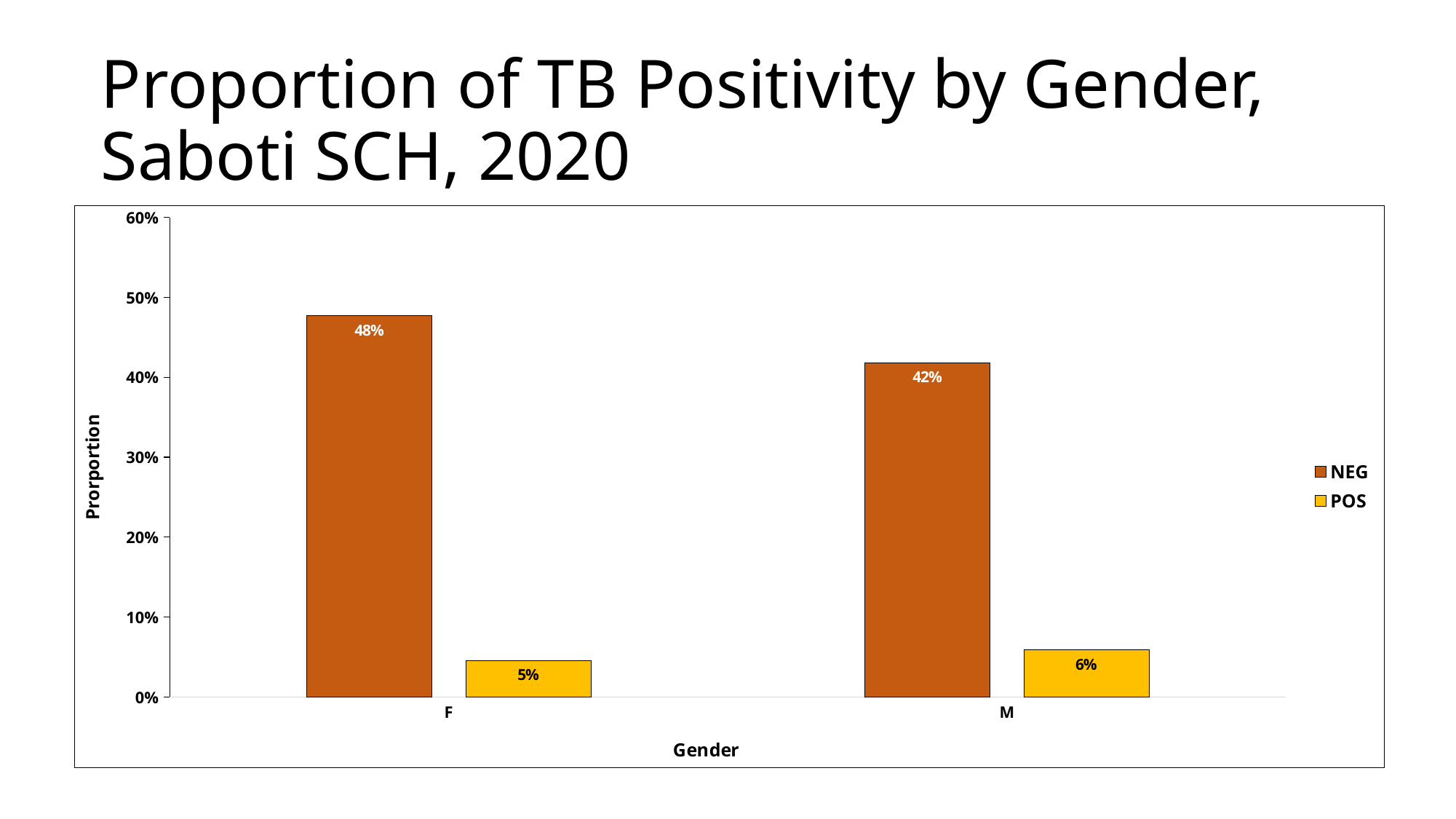
How many series does the legend list? 2 What is the difference between the NEG values for F and M? 6% What is the POS value for M? 6% Is the NEG value for M greater or less than 40%? greater What kind of chart is shown on the slide? Bar chart What is the POS value for F? 5% What is the NEG value for F? 48% What is the label of the y axis? Prorportion What is the NEG value for M? 42% Which gender has the higher NEG value? F Which gender has the lower POS value? F How many gender categories are shown on the x axis? 2